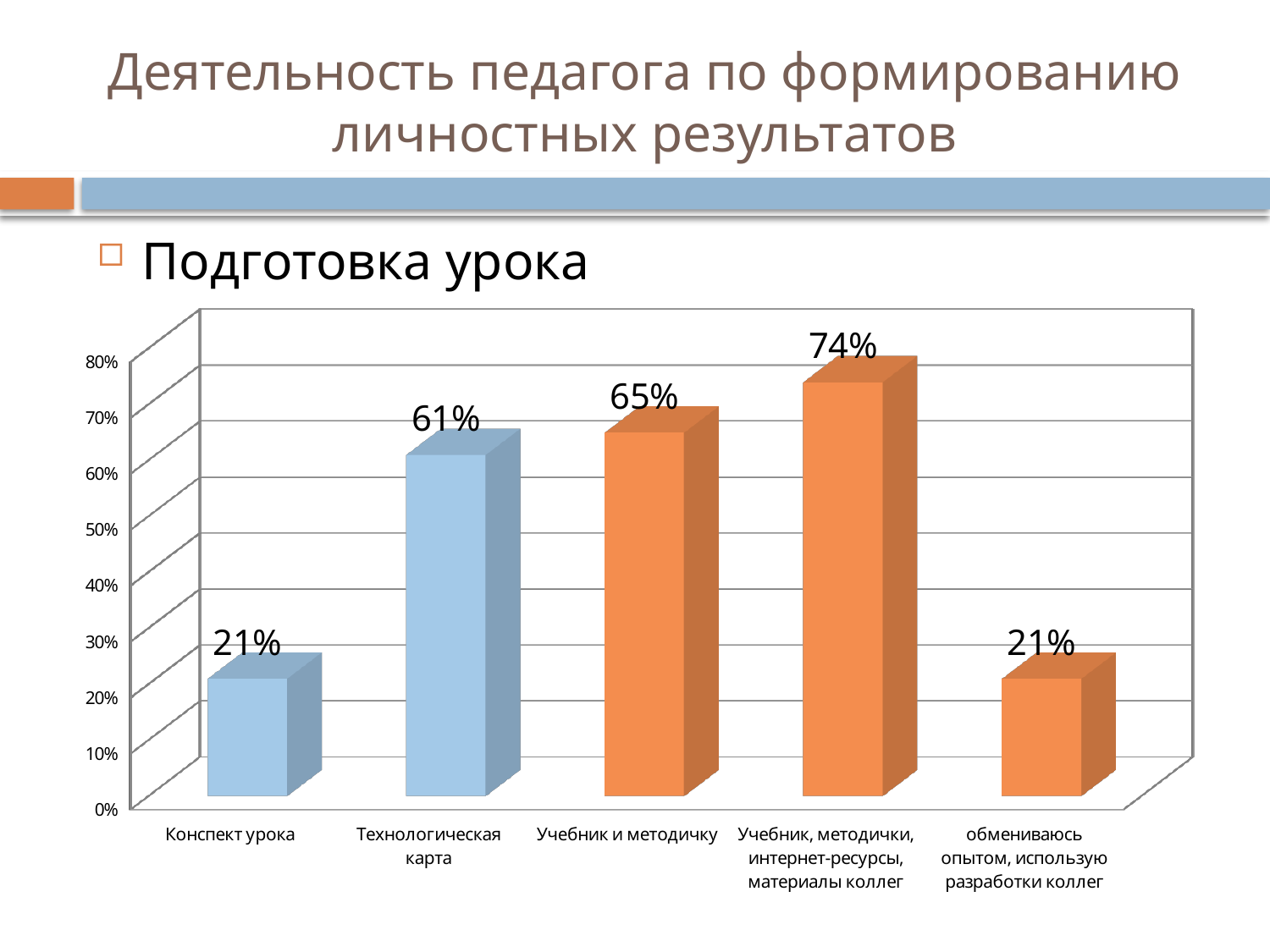
What is the value for Учебник, методички, интернет-ресурсы, материалы коллег? 74% Which is larger, the value for Технологическая карта or the value for Учебник и методичку? Учебник и методичку What is the highest value shown on the vertical axis? 80% Which category has the highest value? Учебник, методички, интернет-ресурсы, материалы коллег What kind of chart is shown on the slide? bar chart Is the value for Технологическая карта greater or less than 50%? greater What is the difference between the values for Учебник и методичку and Конспект урока? 44% How many categories are shown on the chart? 5 What is the difference between the values for Учебник, методички, интернет-ресурсы, материалы коллег and Технологическая карта? 13% What is the value for Учебник и методичку? 65% What is the value for Конспект урока? 21% What is the value for Технологическая карта? 61%